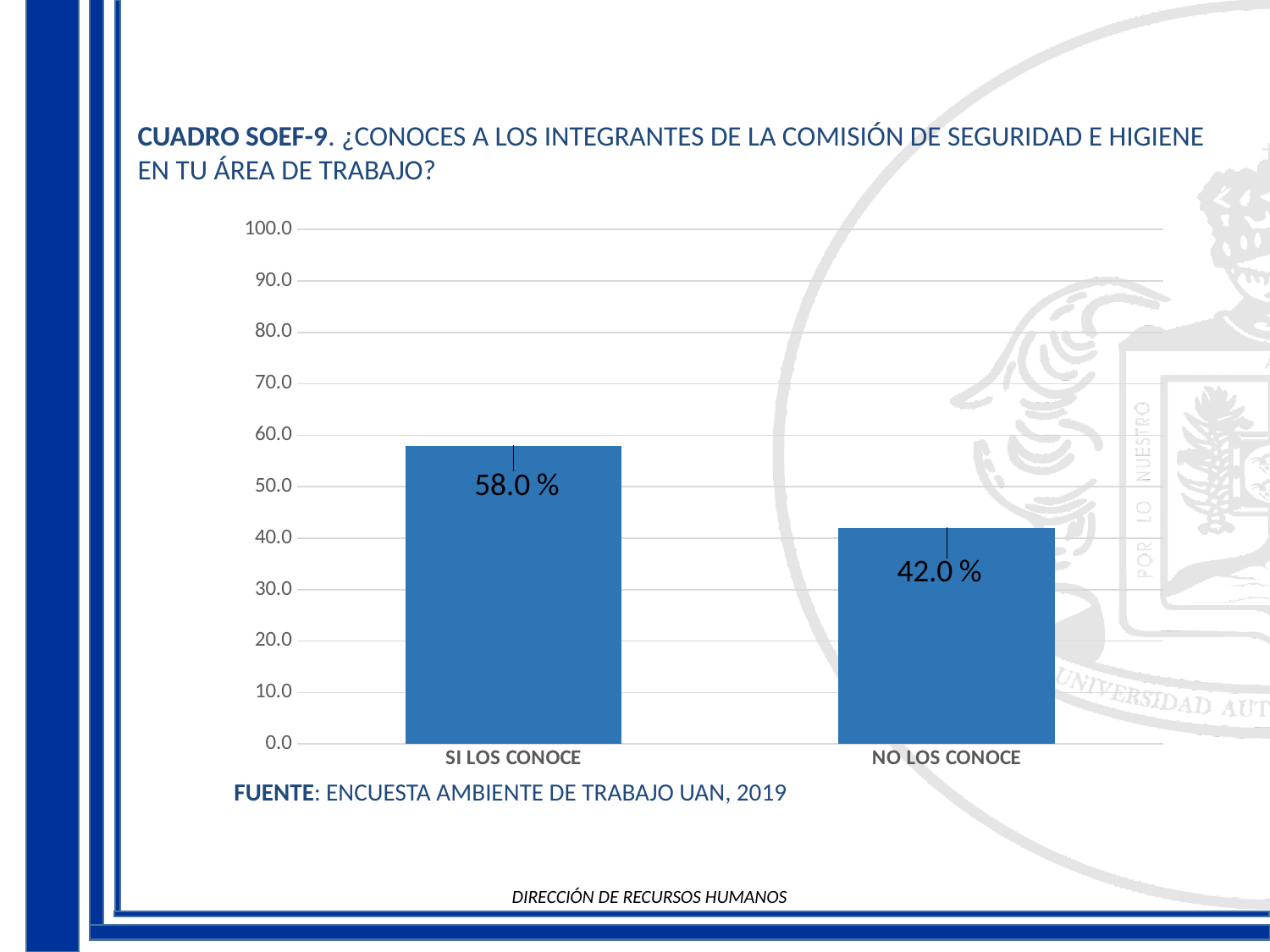
What is the difference between the values for SI LOS CONOCE and NO LOS CONOCE? 16.0 % What is the value for SI LOS CONOCE? 58.0 % Which is larger, the value for SI LOS CONOCE or the value for NO LOS CONOCE? SI LOS CONOCE What is the value for NO LOS CONOCE? 42.0 % How many categories are shown on the x axis? 2 Is the value for SI LOS CONOCE greater or less than 50.0? greater Is the value for NO LOS CONOCE greater or less than 50.0? less Which category has the lowest value? NO LOS CONOCE What is the total of the two bar values? 100.0 % What kind of chart is shown on the slide? bar chart What is the source cited below the chart? ENCUESTA AMBIENTE DE TRABAJO UAN, 2019 Which category has the highest value? SI LOS CONOCE